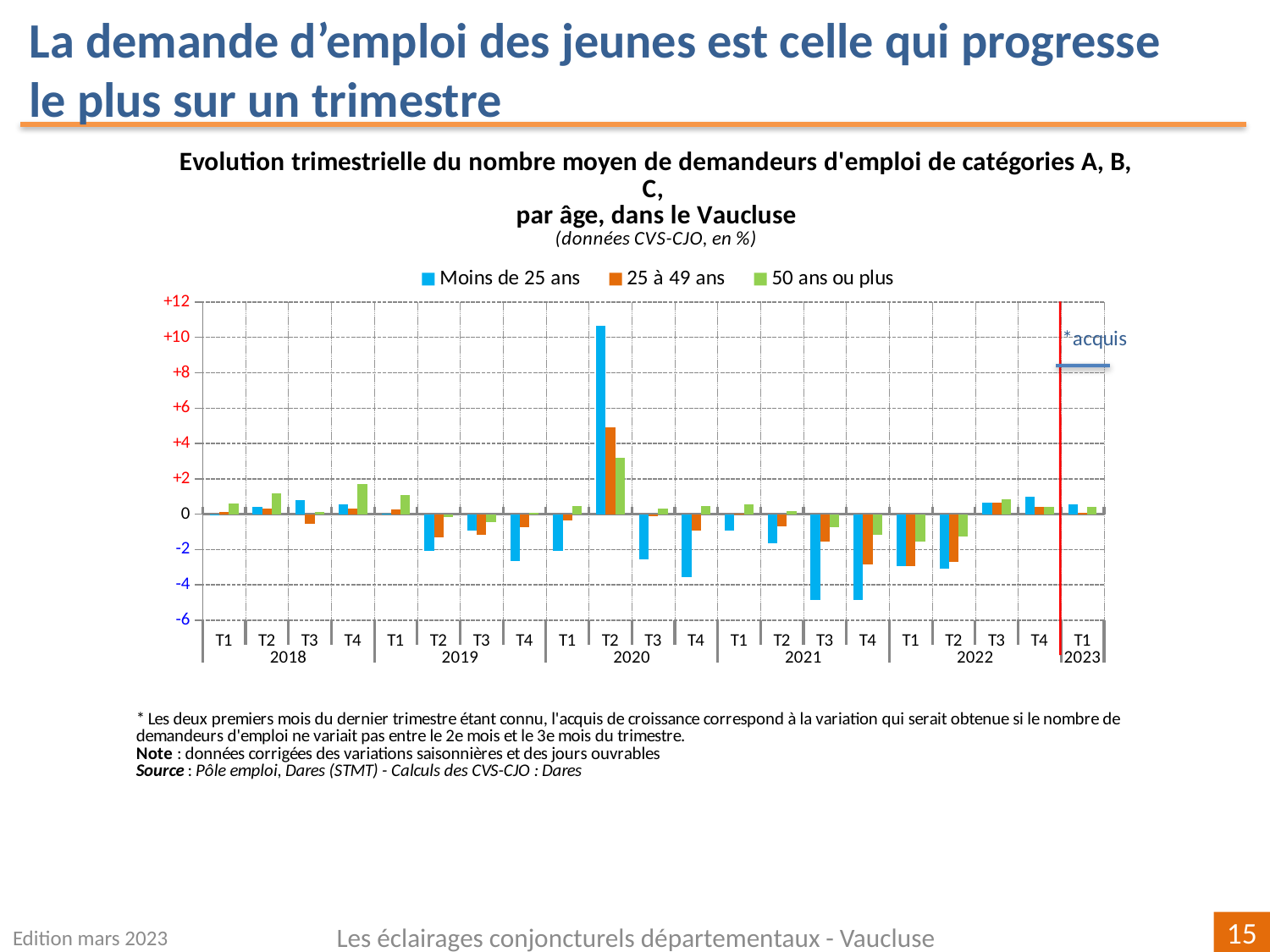
Which quarter is marked as 'acquis' by the red vertical line? T1 2023 What kind of chart is shown on the slide? bar chart How many series does the legend list? 3 How many quarters are plotted along the x axis? 21 Is the value for 'Moins de 25 ans' in T3 2021 greater or less than -4? less Is the value for '50 ans ou plus' in T2 2020 greater or less than +2? greater Is the value for '25 à 49 ans' in T2 2020 greater or less than +4? greater In which quarter does the 'Moins de 25 ans' series reach its highest value? T2 2020 Which colour represents the 'Moins de 25 ans' series? blue In T2 2020, which series has the larger value: 'Moins de 25 ans' or '25 à 49 ans'? Moins de 25 ans